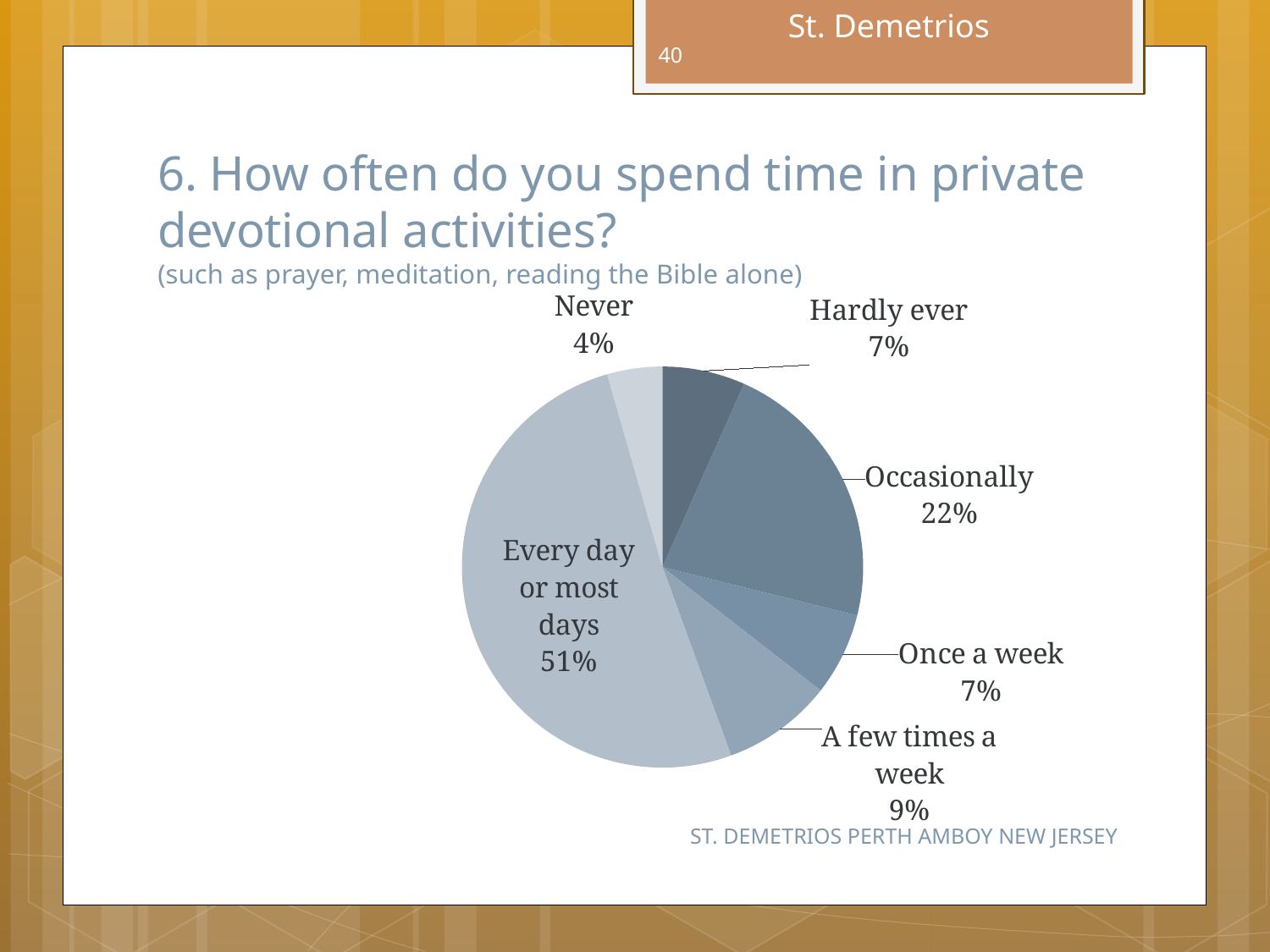
What kind of chart is shown on the slide? pie chart What is the difference in percentage points between "Every day or most days" and "Occasionally"? 29 What percentage answered "Occasionally"? 22% What is the combined percentage of "Hardly ever" and "Never"? 11% What percentage answered "Never"? 4% Which response has the largest slice of the pie? Every day or most days Which two responses have the same percentage? Hardly ever and Once a week Which response has the smallest slice of the pie? Never What share of respondents answered "Every day or most days"? 51% Which is larger, the share for "A few times a week" or the share for "Once a week"? A few times a week How many slices does the pie chart have? 6 What percentage answered "A few times a week"? 9%